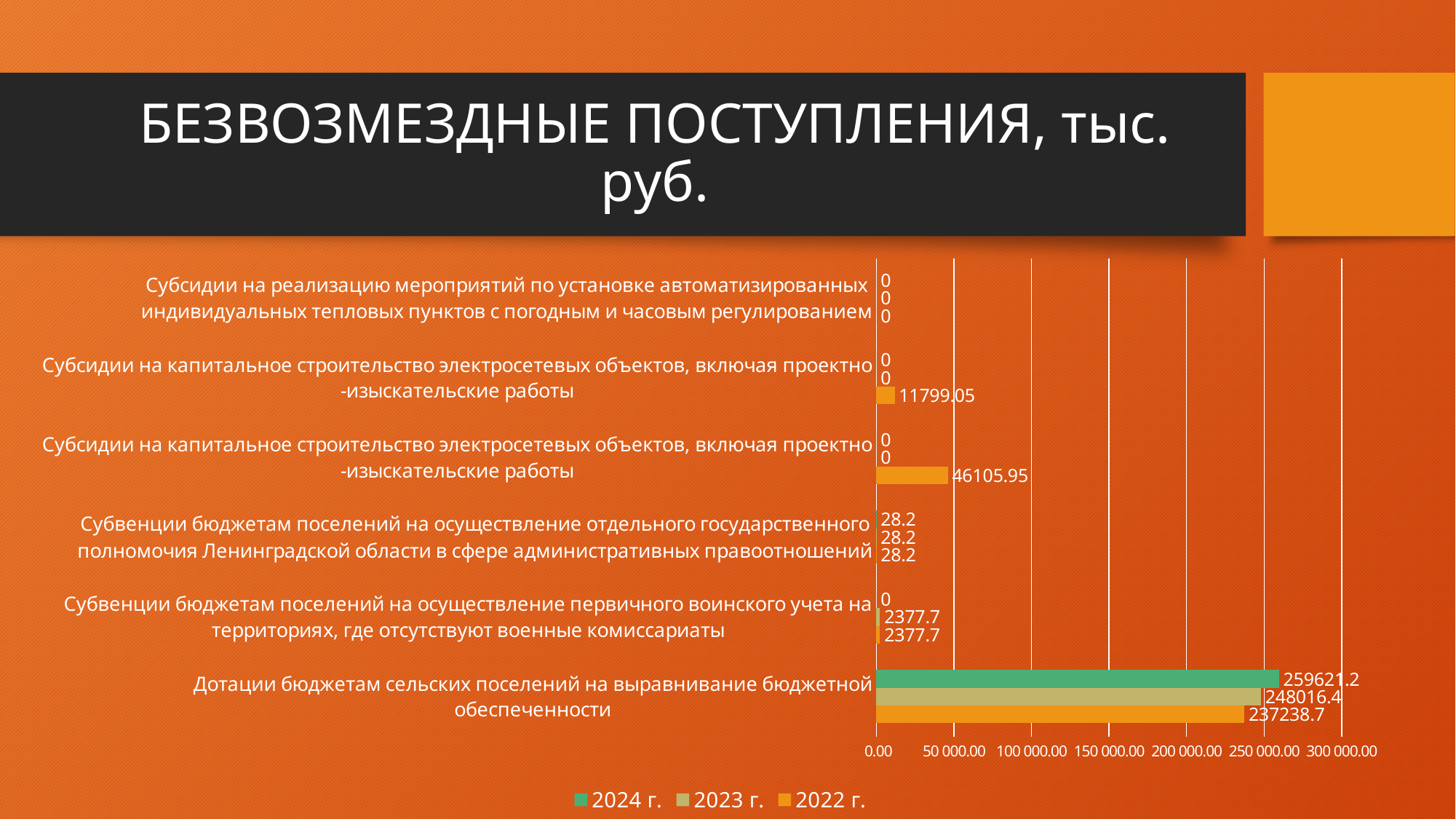
What kind of chart is shown on the slide? Bar chart What is the 2023 г. value for «Субвенции бюджетам поселений на осуществление первичного воинского учета на территориях, где отсутствуют военные комиссариаты»? 2377.7 What is the 2022 г. value for «Дотации бюджетам сельских поселений на выравнивание бюджетной обеспеченности»? 237238.7 What is the 2024 г. value for «Дотации бюджетам сельских поселений на выравнивание бюджетной обеспеченности»? 259621.2 What is the 2024 г. value for «Субвенции бюджетам поселений на осуществление первичного воинского учета на территориях, где отсутствуют военные комиссариаты»? 0 How many series does the legend list? 3 For «Дотации бюджетам сельских поселений на выравнивание бюджетной обеспеченности», which is larger: the 2024 г. value or the 2022 г. value? 2024 г. What is the 2023 г. value for «Дотации бюджетам сельских поселений на выравнивание бюджетной обеспеченности»? 248016.4 What is the difference between the 2024 г. and 2022 г. values for «Дотации бюджетам сельских поселений на выравнивание бюджетной обеспеченности»? 22382.5 Which category has the highest 2024 г. value? Дотации бюджетам сельских поселений на выравнивание бюджетной обеспеченности How many categories are shown on the chart? 6 What is the 2022 г. value for «Субвенции бюджетам поселений на осуществление отдельного государственного полномочия Ленинградской области в сфере административных правоотношений»? 28.2